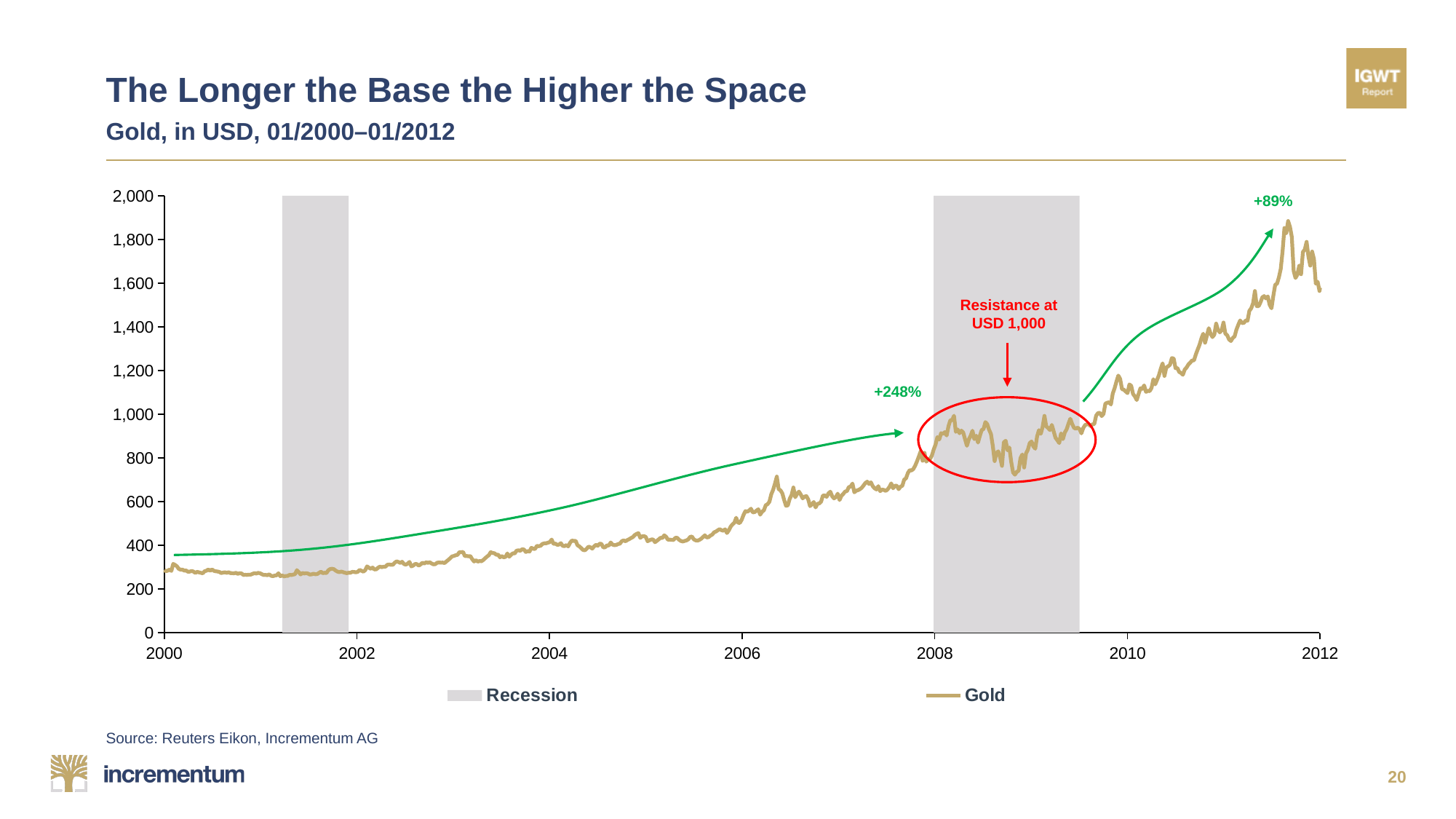
Overall, does the gold price rise or fall from 2000 to 2012? rise Is the gold price at the start of 2010 greater or less than 1,000? greater Is the gold price at the start of 2000 greater or less than 400? less What percentage gain is annotated on the second green arrow, covering roughly 2009 to 2011? +89% How many entries does the legend list? 2 What percentage gain is annotated on the first green arrow, covering roughly 2000 to 2008? +248% Which is higher, the gold price in 2011 or the gold price in 2002? 2011 Is the gold price at the start of 2004 greater or less than 600? less What kind of chart is shown on the slide? line chart At what level does the red annotation say gold met resistance? USD 1,000 What are the two entries in the legend? Recession and Gold What is the subtitle of the chart describing the data and period shown? Gold, in USD, 01/2000–01/2012